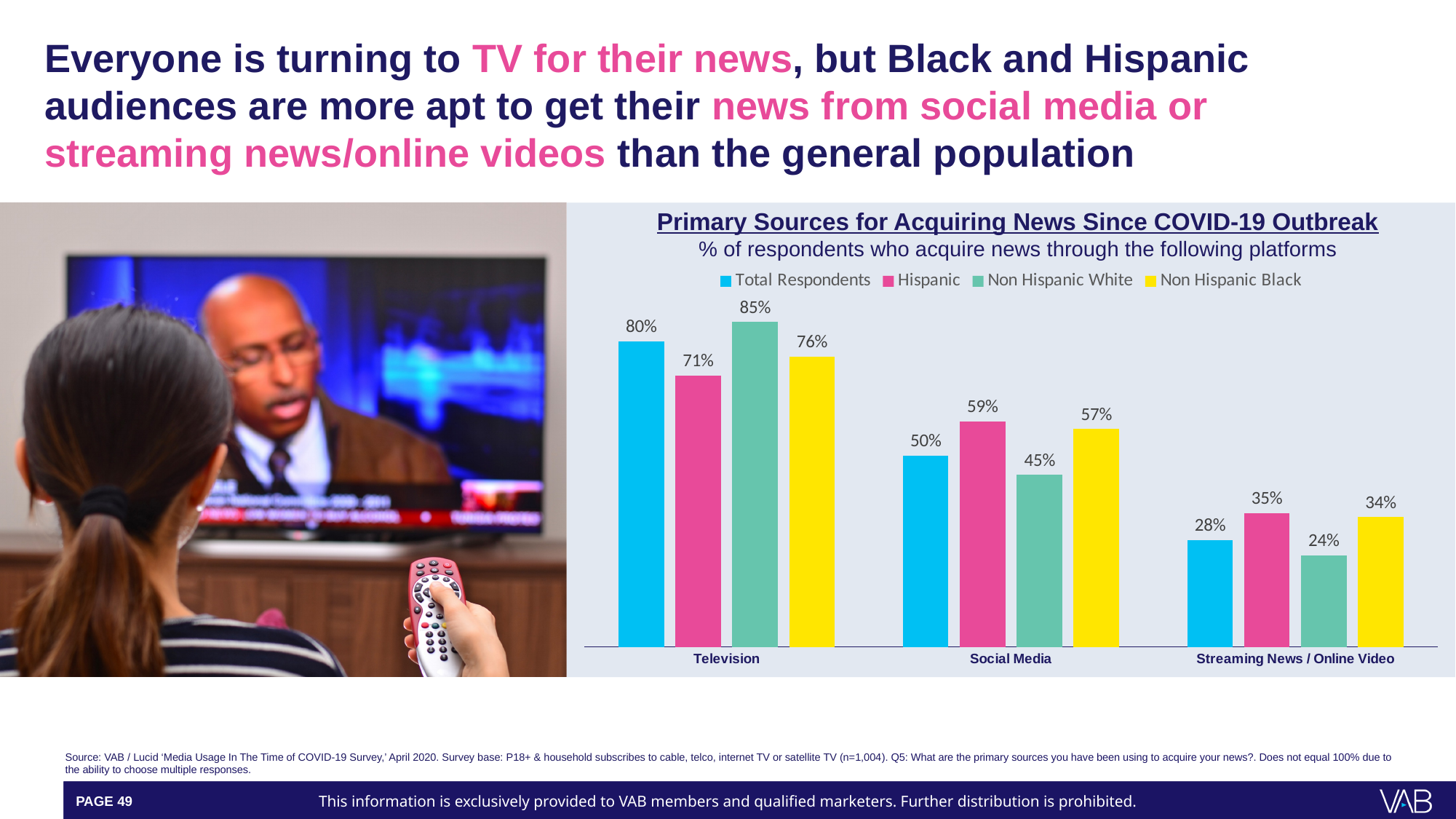
Which group has the highest value for Television? Non Hispanic White What is the title of the chart? Primary Sources for Acquiring News Since COVID-19 Outbreak How many news platform categories are shown on the x axis? 3 What percentage of Total Respondents acquire news through Streaming News / Online Video? 28% How many series does the legend list? 4 What percentage of Non Hispanic White respondents acquire news through Television? 85% What is the difference between the Hispanic and Total Respondents values for Social Media? 9% Do the Total Respondents values rise or fall from Television to Streaming News / Online Video? Fall What percentage of Hispanic respondents acquire news through Social Media? 59% Which group has the lowest value for Streaming News / Online Video? Non Hispanic White What kind of chart is shown on the slide? Bar chart Which is larger for Streaming News / Online Video: the Hispanic value or the Non Hispanic Black value? Hispanic